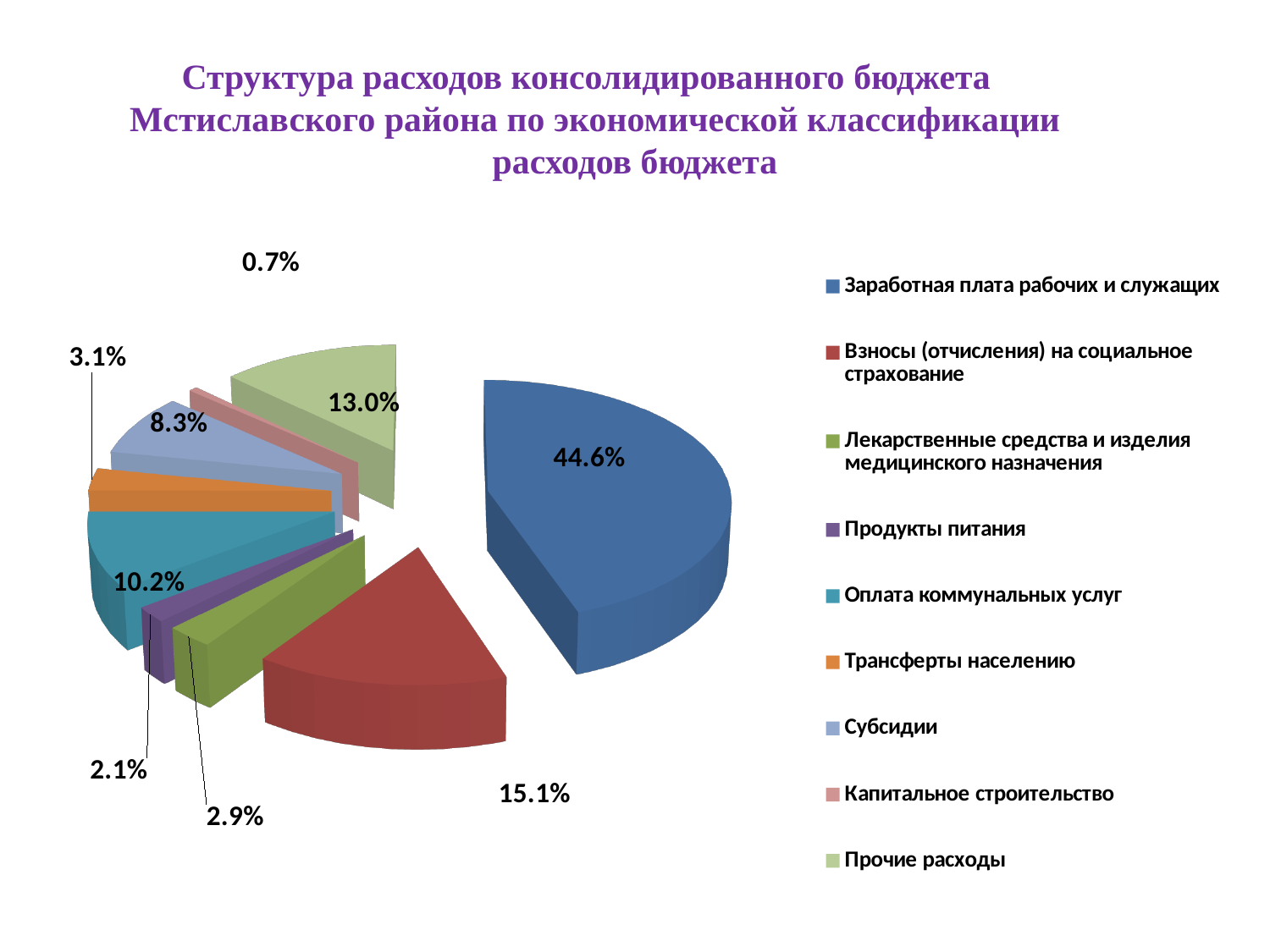
What share of the pie does Заработная плата рабочих и служащих represent? 44.6% How many categories does the legend list? 9 What colour is the slice for Продукты питания? Purple What is the value shown for Взносы (отчисления) на социальное страхование? 15.1% What type of chart is shown on the slide? Pie chart Which category has the smallest share of the pie? Капитальное строительство What is the value for Прочие расходы? 13.0% What percentage is shown for Оплата коммунальных услуг? 10.2% Which category has the largest share of the pie? Заработная плата рабочих и служащих What is the difference between the shares of Взносы (отчисления) на социальное страхование and Прочие расходы? 2.1% Which is larger: the share for Трансферты населению or the share for Лекарственные средства и изделия медицинского назначения? Трансферты населению What share is shown for Субсидии? 8.3%